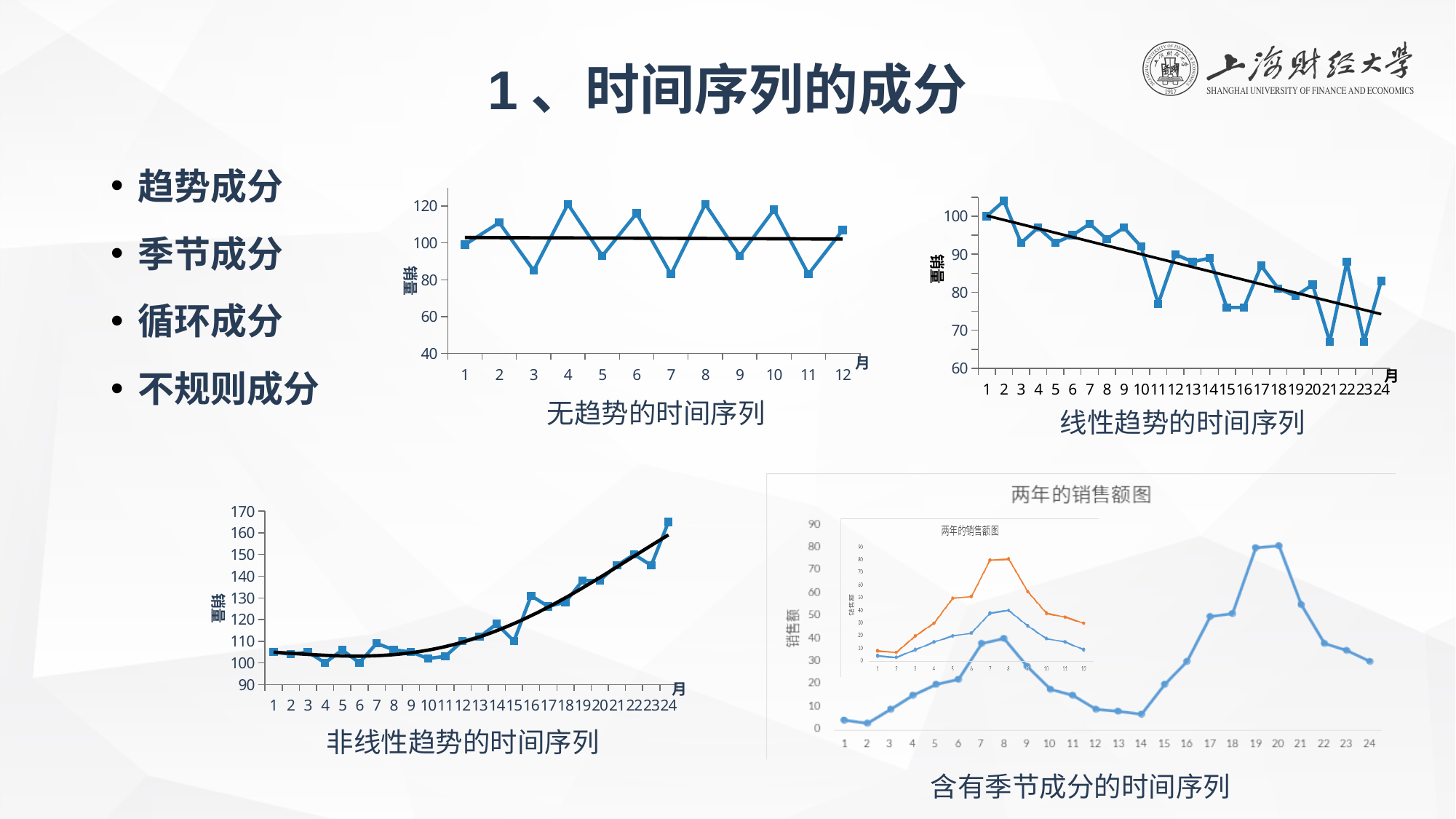
In the chart titled 无趋势的时间序列, is the value for month 7 greater or less than 90? less In the chart titled 非线性趋势的时间序列, do the values generally rise or fall along the x axis? rise In the bottom-right chart titled 两年的销售额图, what is the label on the y axis? 销售额 In the chart titled 线性趋势的时间序列, do the values generally rise or fall along the x axis? fall In the chart titled 非线性趋势的时间序列, is the value for month 24 greater or less than 160? greater In the chart titled 线性趋势的时间序列, is the value for month 21 greater or less than 70? less In the chart titled 线性趋势的时间序列, how many months are plotted on the x axis? 24 In the bottom-right chart, what is the title shown above the plot? 两年的销售额图 What kind of chart is the chart titled 无趋势的时间序列? line chart In the chart titled 无趋势的时间序列, how many months are plotted on the x axis? 12